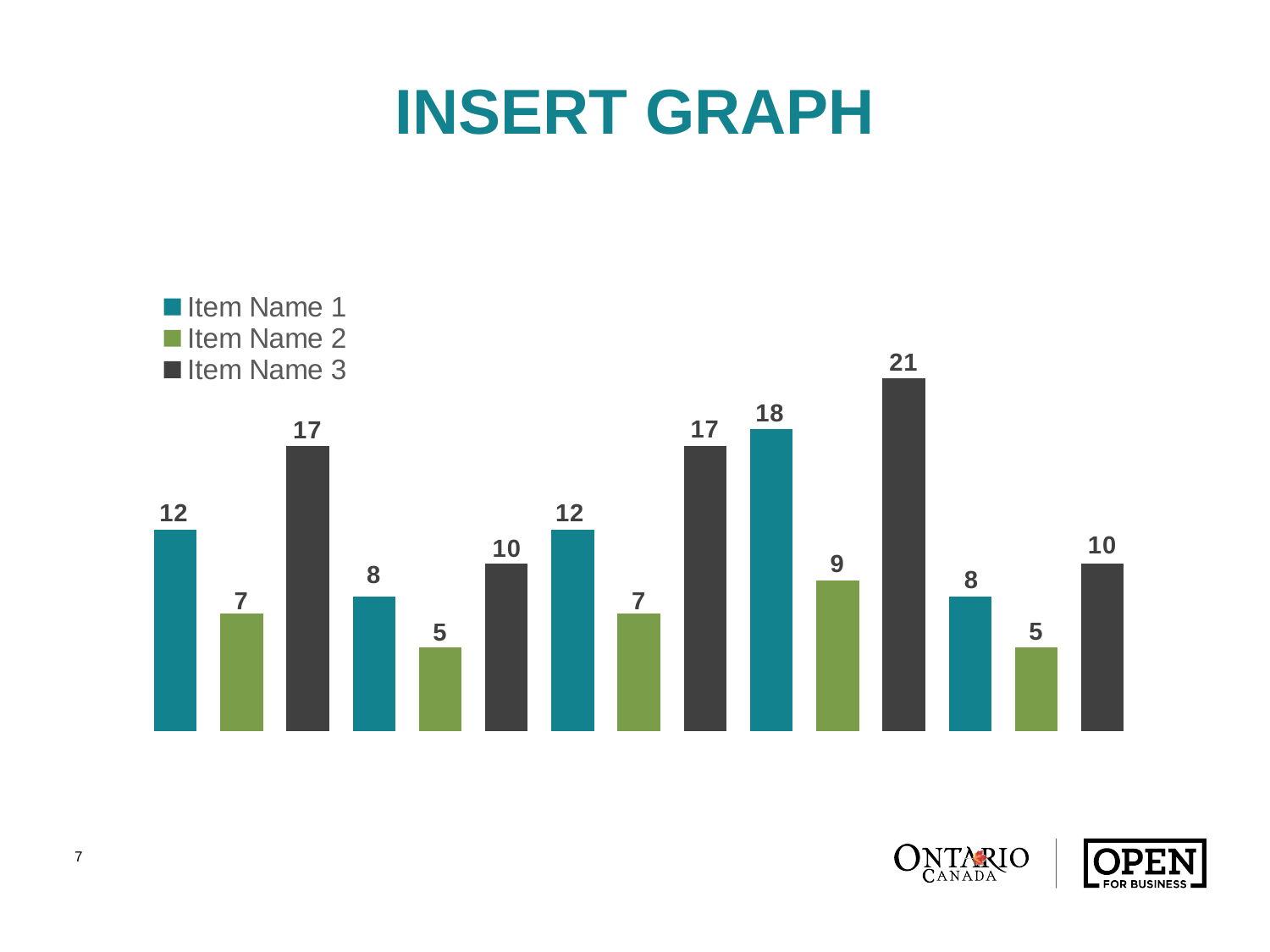
In the first group of bars, which series has the larger value, Item Name 1 or Item Name 3? Item Name 3 What is the title of the chart slide? INSERT GRAPH What is the value of the Item Name 3 bar in the fourth group of bars? 21 Which series is shown in green in the legend? Item Name 2 What is the highest value shown in the chart? 21 In the fourth group of bars, what is the difference between the Item Name 1 value and the Item Name 2 value? 9 How many series does the legend list? 3 What is the lowest value shown in the chart? 5 What kind of chart is shown on the slide? bar chart What is the value of the Item Name 1 bar in the first group of bars? 12 What is the value of the Item Name 2 bar in the second group of bars? 5 How many groups of bars are plotted in the chart? 5